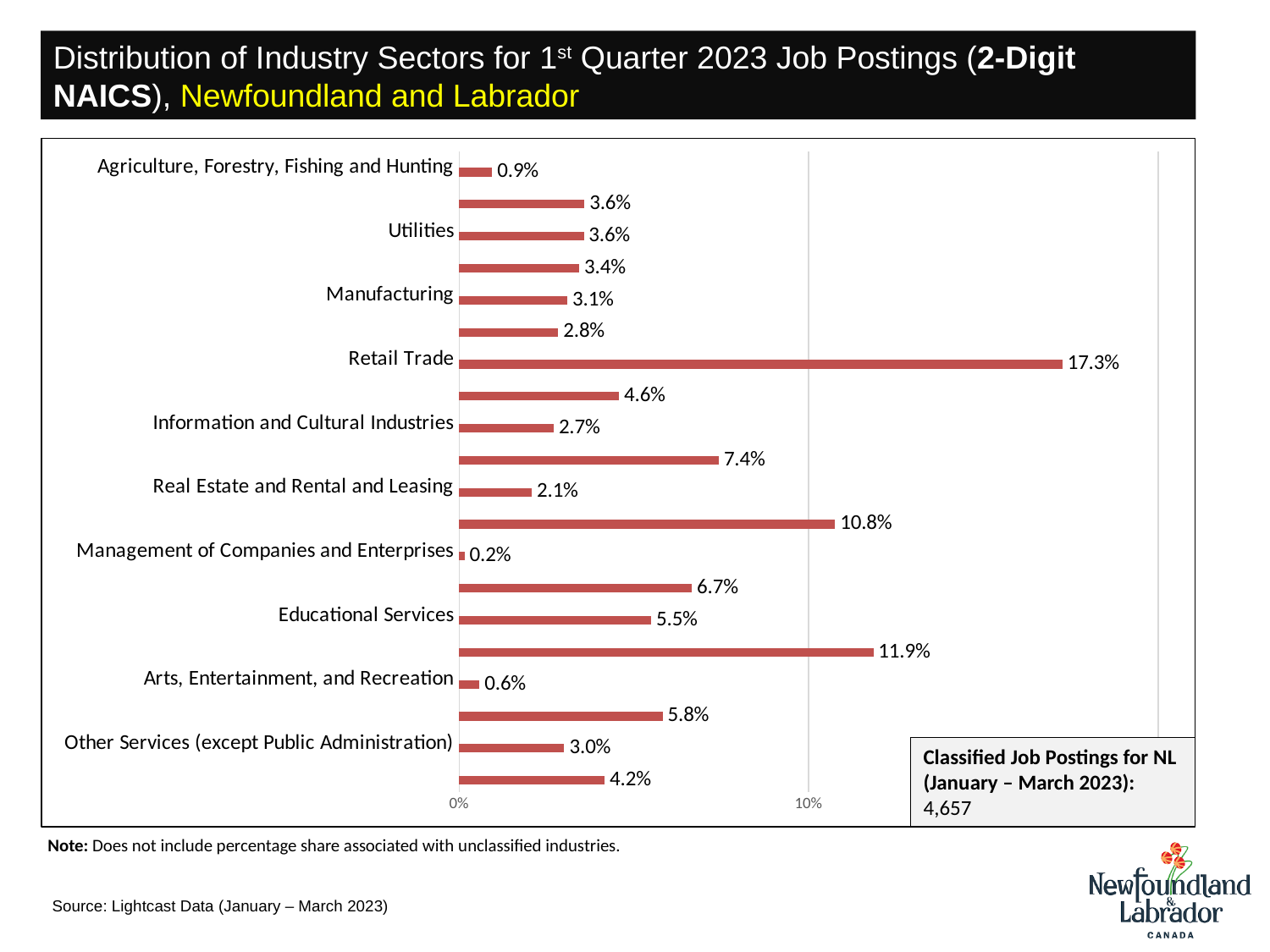
How many bars are plotted in the chart? 20 What kind of chart is shown on the slide? bar chart Which is larger, the value for Manufacturing or the value for Information and Cultural Industries? Manufacturing What is the value for Management of Companies and Enterprises? 0.2% What is the difference between the values for Retail Trade and Educational Services? 11.8% What is the value for Utilities? 3.6% What total number of classified job postings for NL is shown in the box on the chart? 4,657 What is the value for Retail Trade? 17.3% Which labelled sector has the lowest share of job postings? Management of Companies and Enterprises Is the value for Retail Trade greater or less than 10%? greater What is the value for Educational Services? 5.5% Which labelled sector has the highest share of job postings? Retail Trade